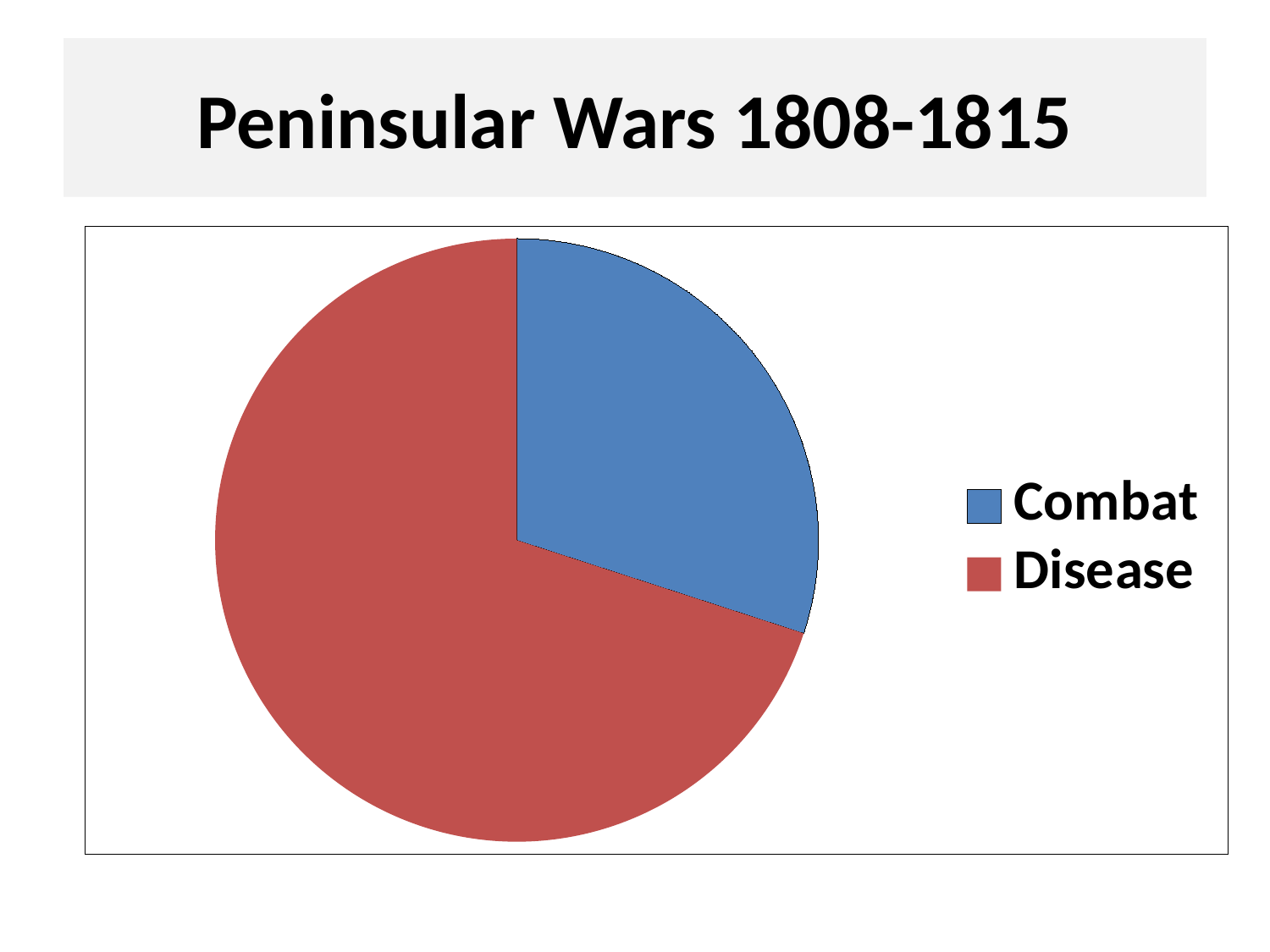
What colour is the Disease slice? red How many entries does the legend list? 2 Which slice is larger, Combat or Disease? Disease How many slices does the pie chart have? 2 What is the title of the slide containing the pie chart? Peninsular Wars 1808-1815 Which category has the smallest slice of the pie? Combat What kind of chart is shown on the slide? pie chart Which category has the largest slice of the pie? Disease